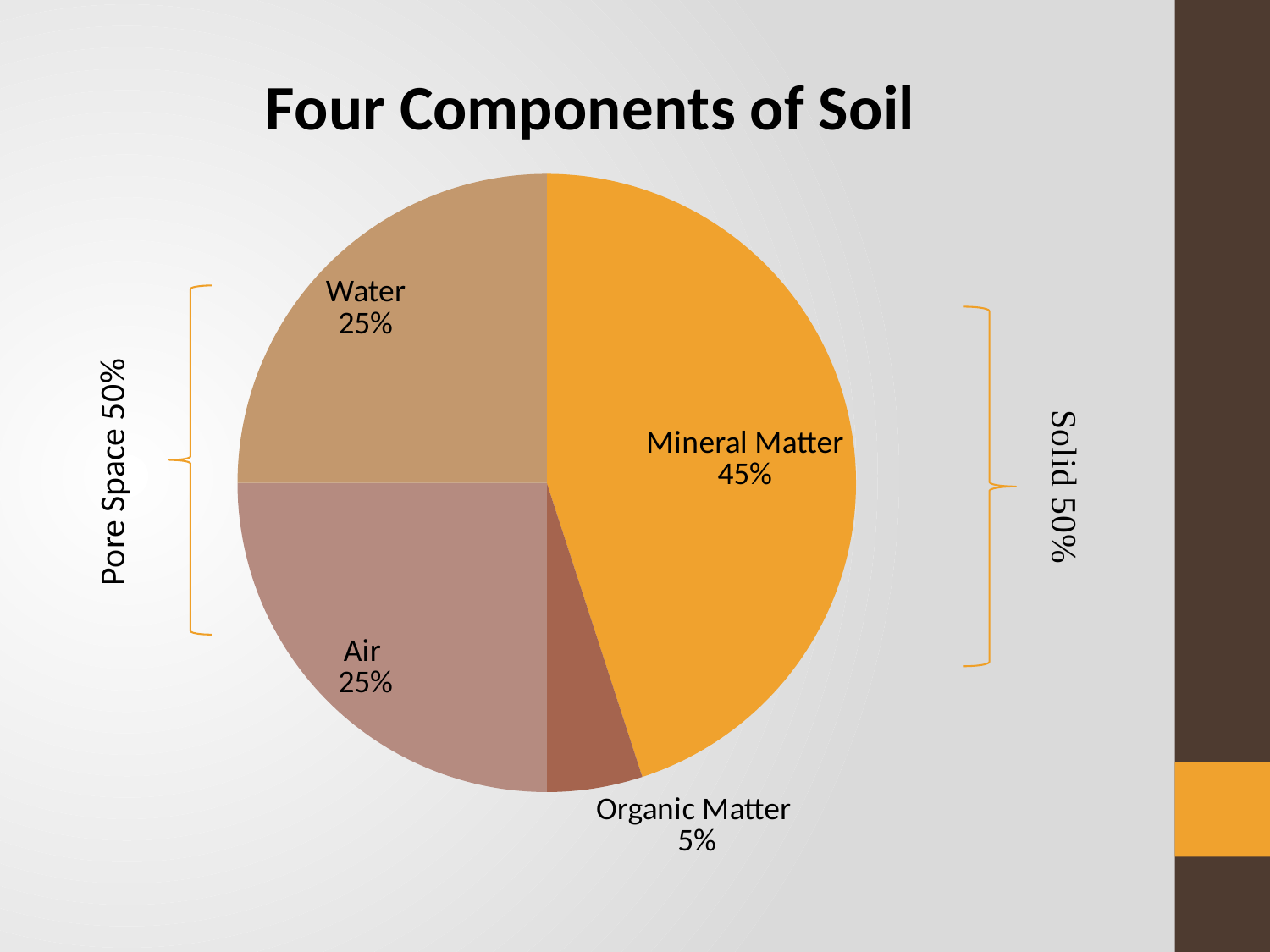
What is the title of the chart? Four Components of Soil What is the combined share of Water and Air, labelled as Pore Space? 50% What percentage of soil is Water? 25% Which component has the largest share of the pie? Mineral Matter What percentage of soil is Organic Matter? 5% Which component has the smallest share of the pie? Organic Matter What percentage of soil is Mineral Matter? 45% Which is larger, the Mineral Matter slice or the Water slice? Mineral Matter How many slices does the pie chart have? 4 What percentage of soil is Air? 25% What kind of chart is shown on the slide? pie chart What is the difference between the Mineral Matter share and the Organic Matter share? 40%